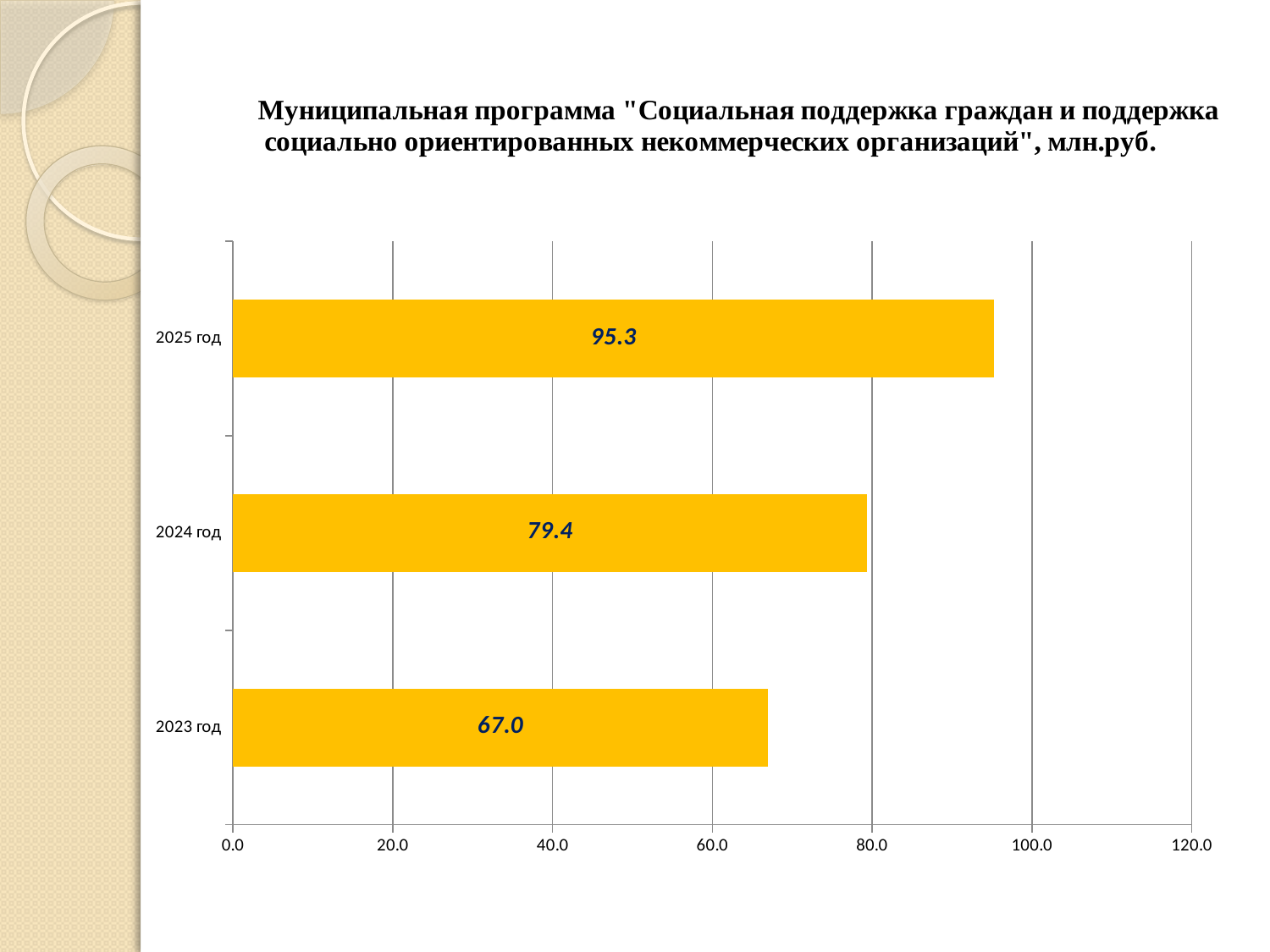
What is the difference between the values for 2025 год and 2023 год? 28.3 What is the value for 2025 год? 95.3 What unit is given in the chart title? млн.руб. Is the value for 2025 год greater or less than 100.0? less Which year has the highest value? 2025 год What is the value for 2023 год? 67.0 What is the difference between the values for 2024 год and 2023 год? 12.4 What is the value for 2024 год? 79.4 Which year has the lowest value? 2023 год What kind of chart is shown on the slide? bar chart Which is larger, the value for 2024 год or the value for 2023 год? 2024 год How many years are shown in the chart? 3